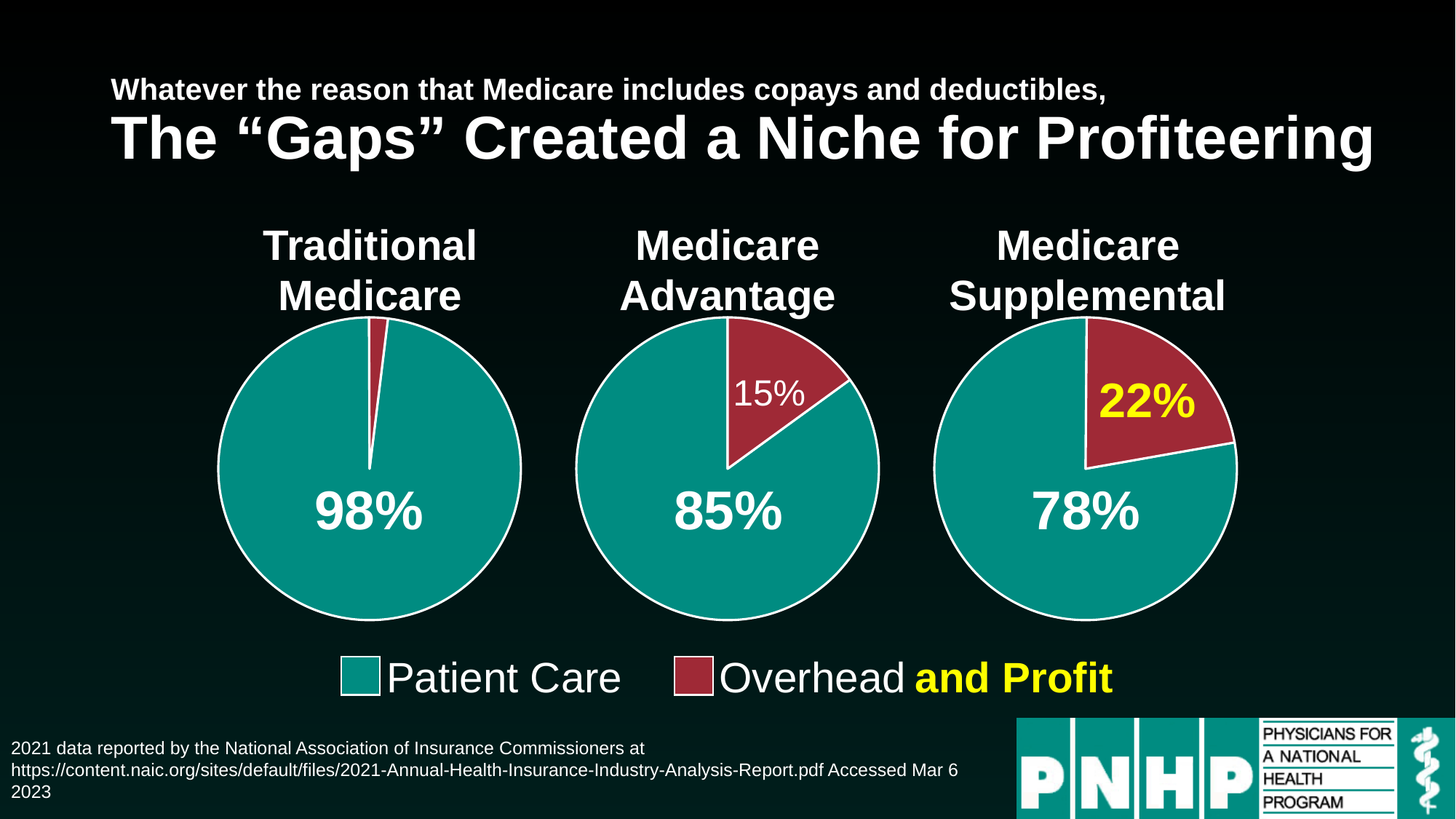
Which colour represents Patient Care in the pie charts? Teal Which of the three pie charts shows the largest Overhead and Profit slice? Medicare Supplemental In the Medicare Advantage pie chart, what share goes to Patient Care? 85% In the Medicare Advantage pie chart, what share goes to Overhead and Profit? 15% Which is larger: the Overhead and Profit share in the Medicare Advantage chart or in the Medicare Supplemental chart? Medicare Supplemental What is the difference between the Patient Care share in the Traditional Medicare chart and the Patient Care share in the Medicare Supplemental chart? 20 percentage points In the Traditional Medicare pie chart, what share goes to Patient Care? 98% How many categories does the shared legend list? 2 Which of the three pie charts shows the smallest Overhead and Profit slice? Traditional Medicare In the Medicare Supplemental pie chart, what share goes to Patient Care? 78% In the Medicare Supplemental pie chart, what share goes to Overhead and Profit? 22% What kind of charts are shown on the slide? Pie charts